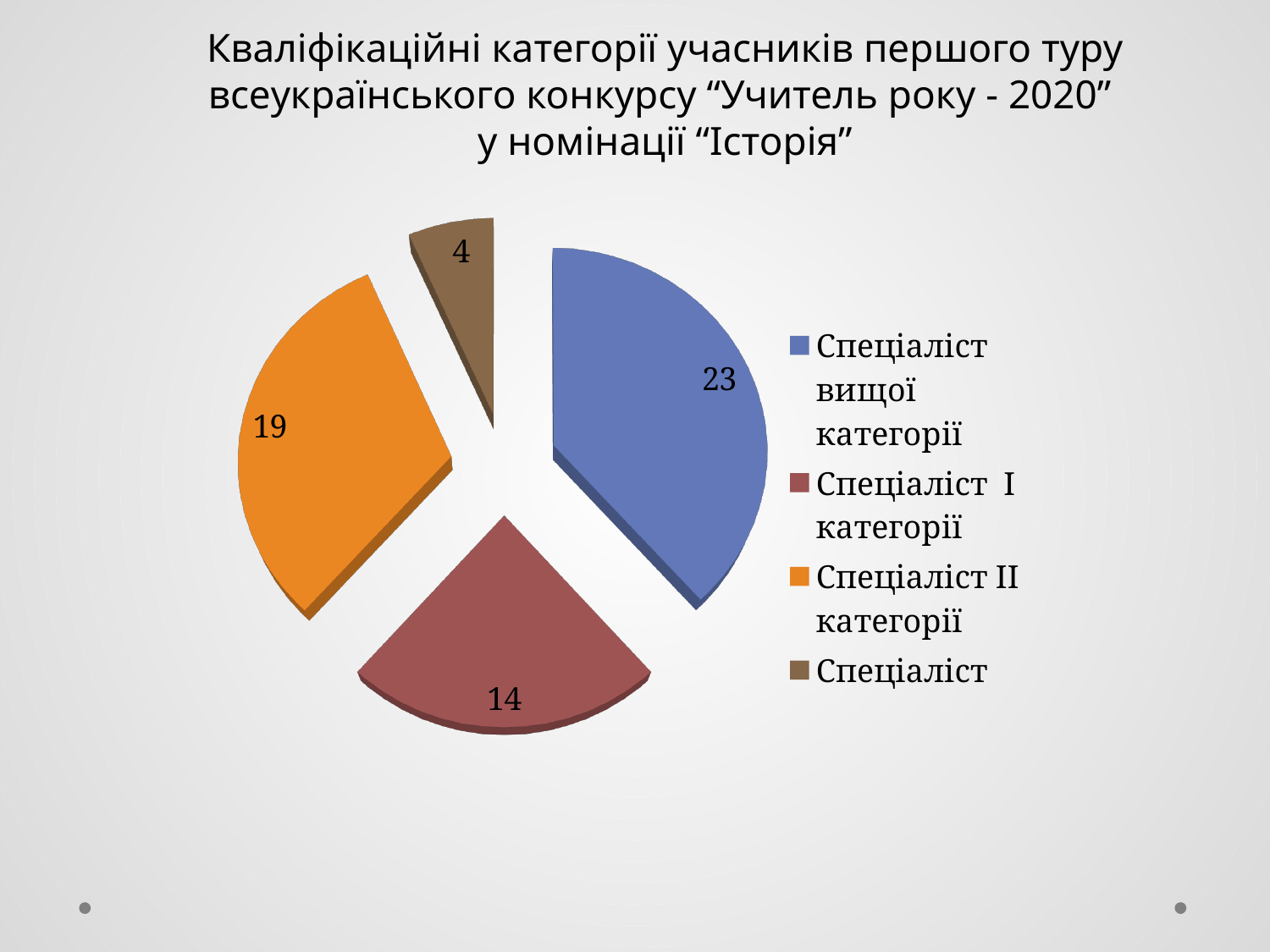
What is the total of all slices in the pie chart? 60 What is the value for "Спеціаліст вищої категорії"? 23 What is the value for "Спеціаліст I категорії"? 14 Which is larger, the value for "Спеціаліст II категорії" or "Спеціаліст I категорії"? Спеціаліст II категорії Which category has the smallest slice? Спеціаліст What is the value for "Спеціаліст II категорії"? 19 What kind of chart is shown on the slide? pie chart What is the value for "Спеціаліст"? 4 Which category has the largest slice? Спеціаліст вищої категорії What colour is the slice for "Спеціаліст II категорії"? orange How many categories does the pie chart have? 4 What is the difference between the values for "Спеціаліст вищої категорії" and "Спеціаліст I категорії"? 9